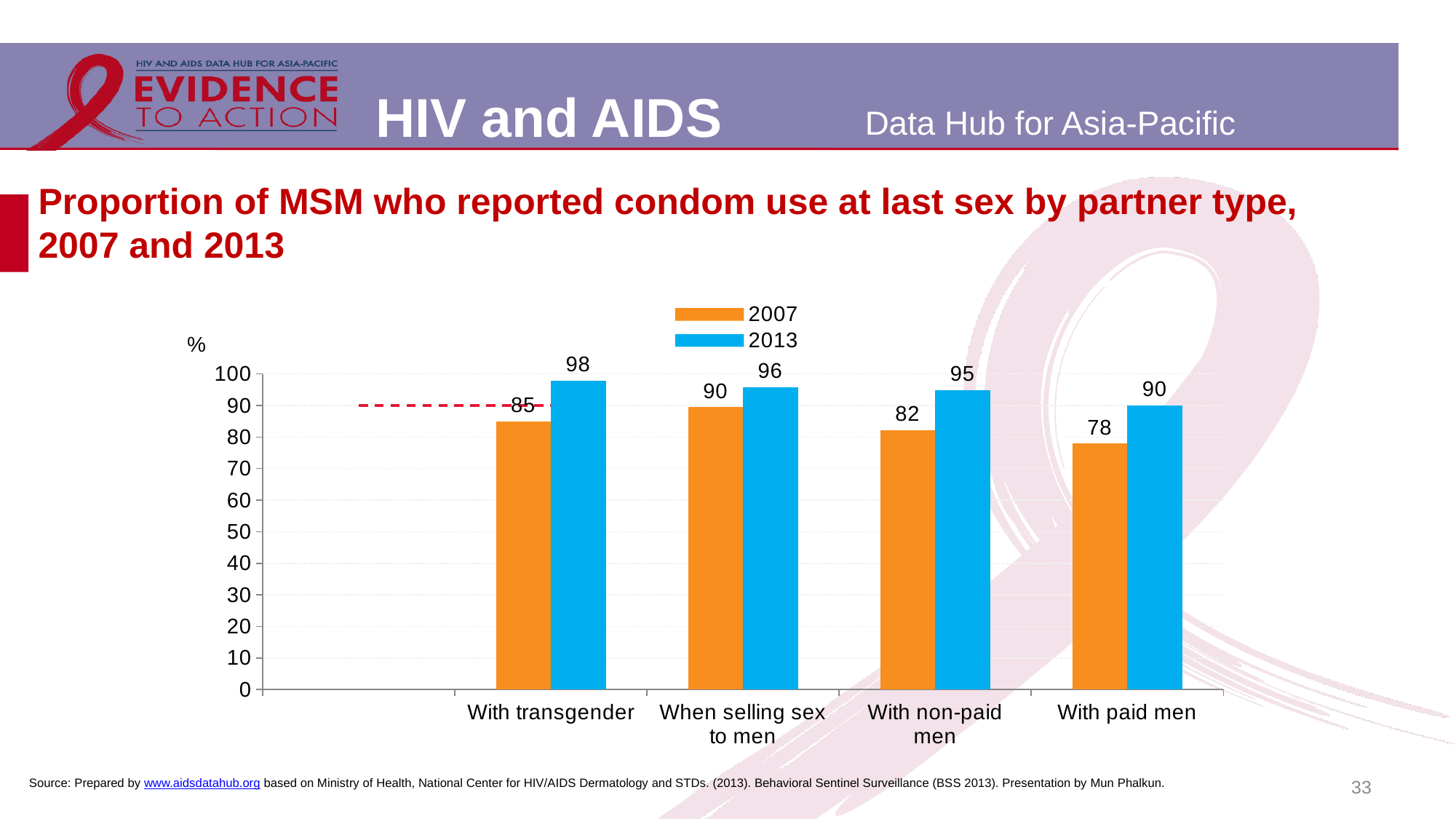
Which is larger: the 2007 value for 'With non-paid men' or the 2007 value for 'When selling sex to men'? When selling sex to men How many series does the legend list? 2 Which partner type had the highest reported condom use in 2013? With transgender What was the 2007 value for condom use when selling sex to men? 90 What was the proportion of MSM who reported condom use at last sex with transgender partners in 2013? 98 How many partner type categories are shown on the x axis? 4 Which colour represents the 2013 series in the chart? Blue What type of chart is shown on the slide? Bar chart By how many percentage points did condom use with paid men increase from 2007 to 2013? 12 Which partner type had the lowest reported condom use in 2007? With paid men What was the proportion of MSM who reported condom use at last sex with paid men in 2007? 78 What is the difference between the 2013 values for 'With transgender' and 'With non-paid men'? 3